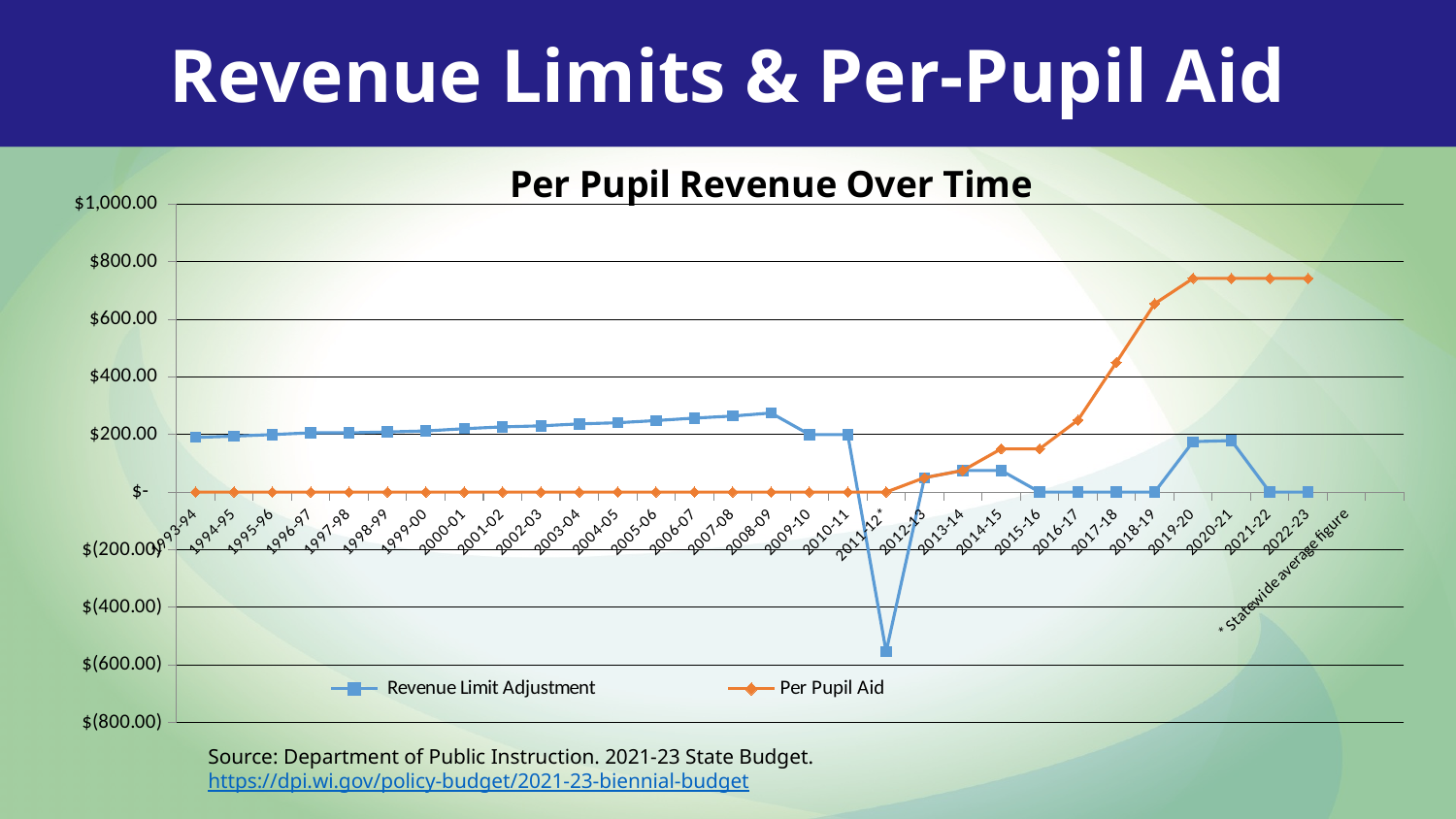
Is the Per Pupil Aid value for 2020-21 greater or less than $600.00? greater What is the Per Pupil Aid value for 2005-06? $- What is the title of the chart? Per Pupil Revenue Over Time Which series is drawn in orange? Per Pupil Aid In which year is the Revenue Limit Adjustment at its lowest? 2011-12 What is the Revenue Limit Adjustment value for 2016-17? $- Is the Revenue Limit Adjustment for 2011-12 greater or less than $(400.00)? less Does Per Pupil Aid rise or fall between 2012-13 and 2019-20? Rise What kind of chart is shown on the slide? Line chart How many school years are plotted along the x axis? 30 In 2019-20, which series has the higher value, Revenue Limit Adjustment or Per Pupil Aid? Per Pupil Aid How many series does the chart's legend list? 2